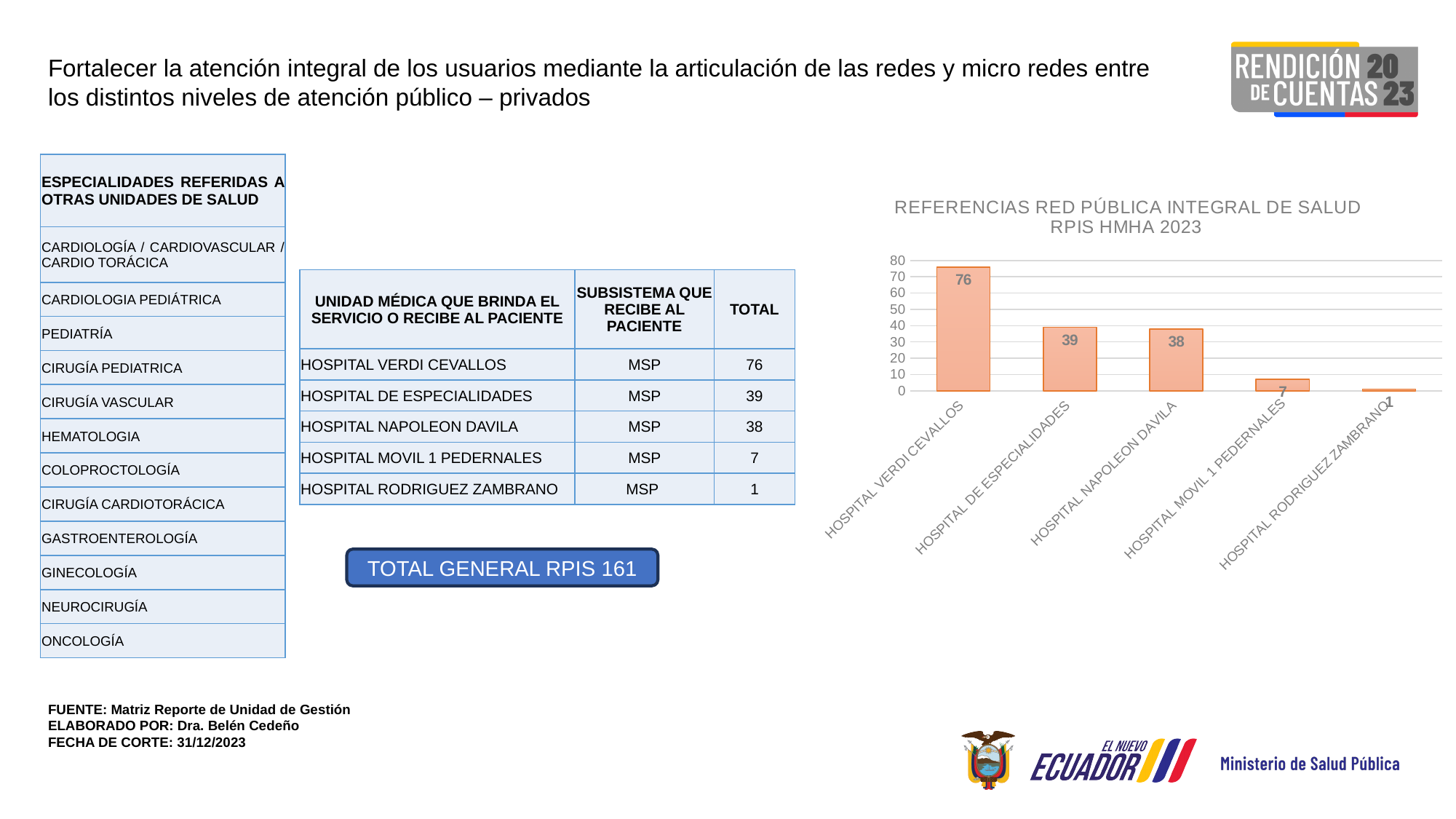
What is the title of the chart? REFERENCIAS RED PÚBLICA INTEGRAL DE SALUD RPIS HMHA 2023 What is the value for HOSPITAL NAPOLEON DAVILA in the chart? 38 What is the value for HOSPITAL VERDI CEVALLOS in the chart? 76 Which hospital has the highest value in the chart? HOSPITAL VERDI CEVALLOS Which hospital has the lowest value in the chart? HOSPITAL RODRIGUEZ ZAMBRANO What kind of chart is shown on the slide? bar chart What is the difference between the values for HOSPITAL VERDI CEVALLOS and HOSPITAL DE ESPECIALIDADES? 37 How many hospitals are shown on the x axis of the chart? 5 What is the value for HOSPITAL DE ESPECIALIDADES in the chart? 39 Which is larger, the value for HOSPITAL NAPOLEON DAVILA or HOSPITAL MOVIL 1 PEDERNALES? HOSPITAL NAPOLEON DAVILA What is the value for HOSPITAL MOVIL 1 PEDERNALES in the chart? 7 Is the value for HOSPITAL VERDI CEVALLOS greater or less than 70? greater